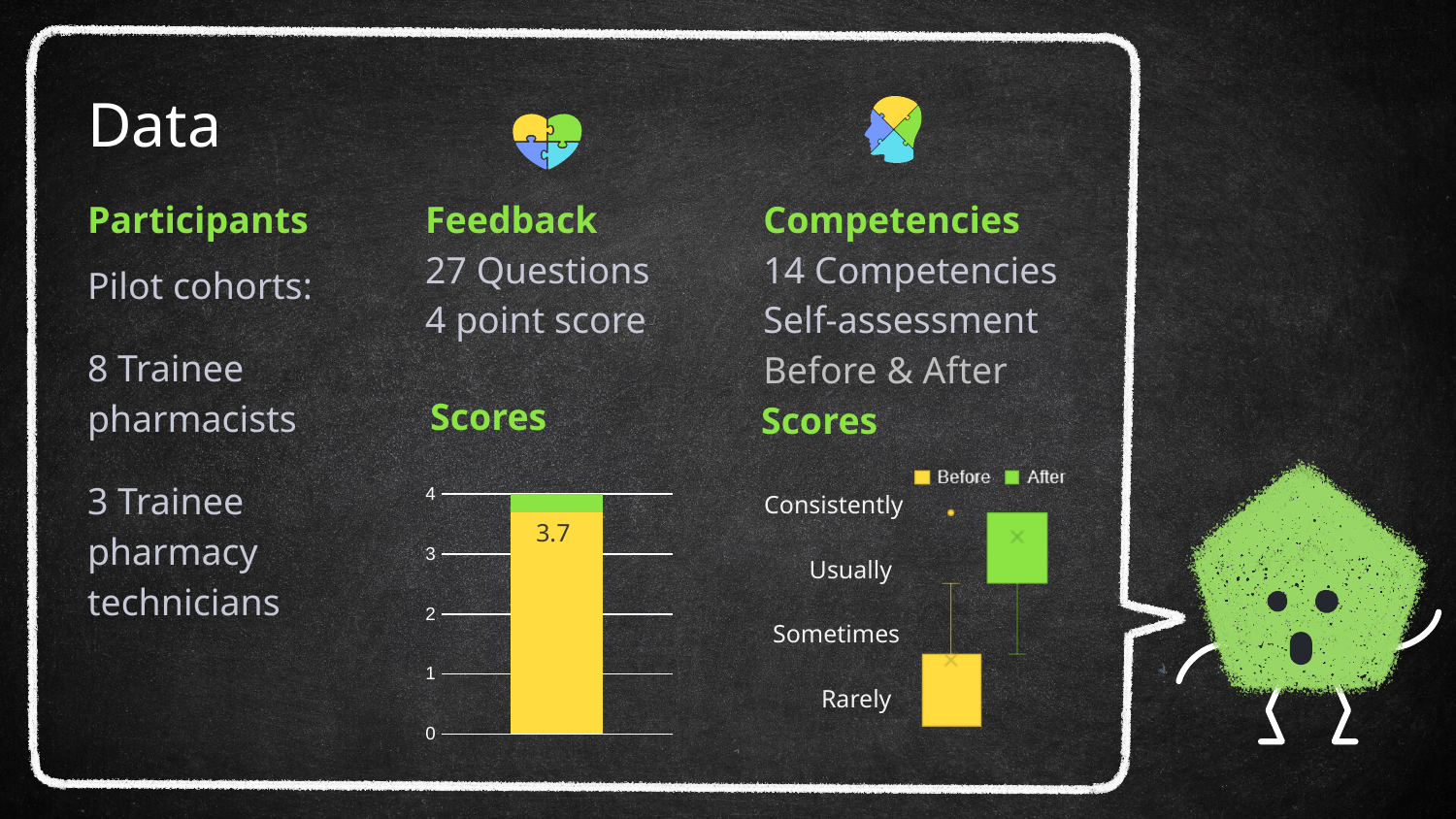
On the Feedback Scores chart, what is the highest value shown on the vertical axis? 4 On the Competencies Scores chart, which rating label is at the bottom of the vertical axis? Rarely On the Competencies Scores chart, which rating label is at the top of the vertical axis? Consistently On the Competencies Scores chart, how many series does the legend list? 2 On the Feedback Scores chart, is the labelled value greater or less than 3? greater What kind of chart is the Competencies Scores chart? box plot On the Competencies Scores chart, which series has the higher box, Before or After? After On the Competencies Scores chart, how many rating labels are shown on the vertical axis? 4 On the Feedback Scores chart, how many bars are plotted? 1 On the Feedback Scores chart, what value is printed on the bar? 3.7 On the Competencies Scores chart, what are the two series named in the legend? Before and After What kind of chart is the Feedback Scores chart? bar chart